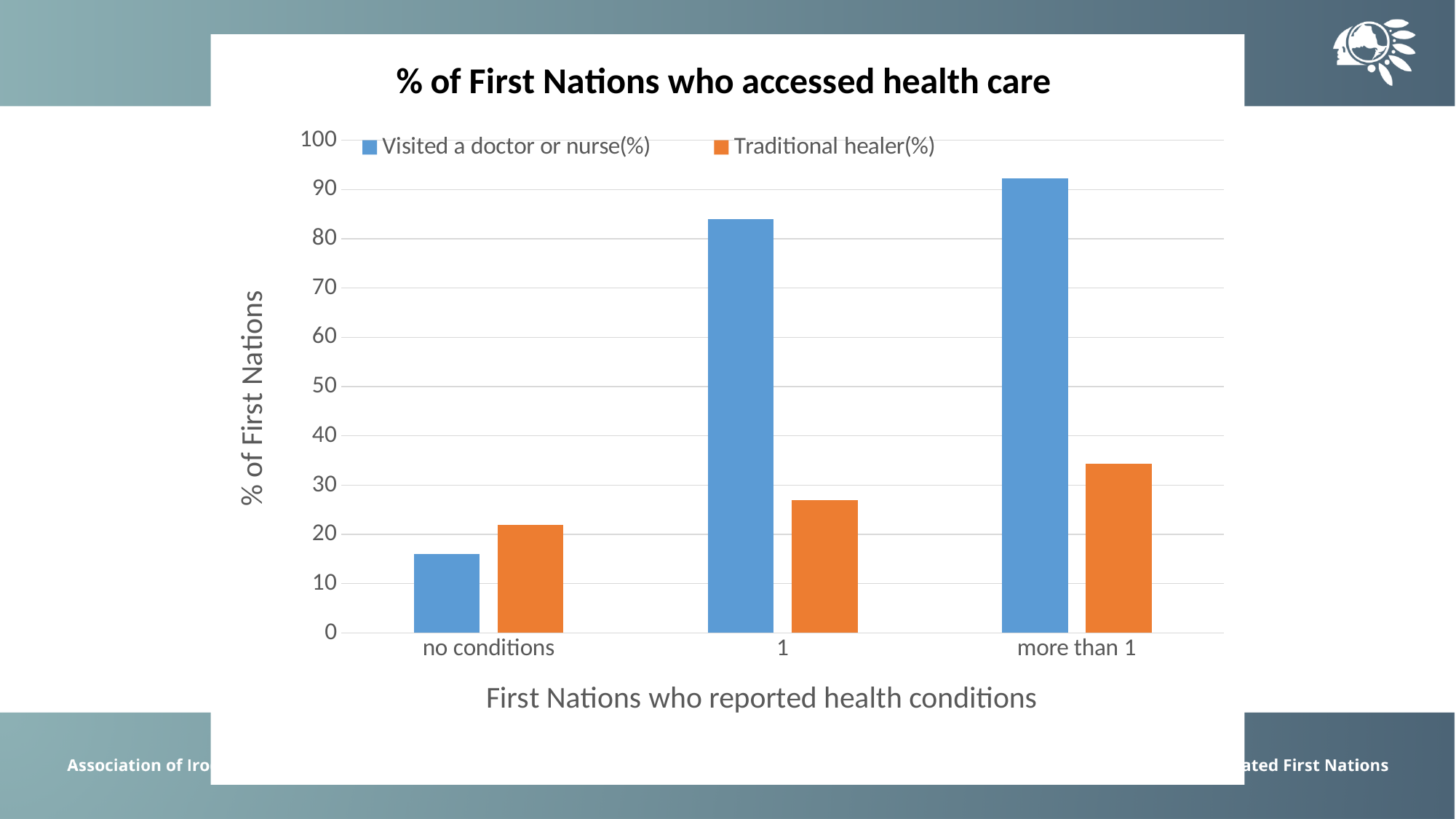
How many series does the legend list? 2 How many categories are shown on the x axis? 3 Which category has the highest value for Visited a doctor or nurse(%)? more than 1 What type of chart is shown on the slide? bar chart Is the value for Traditional healer(%) in the 'more than 1' category greater or less than 30? greater Is the value for Visited a doctor or nurse(%) in the 'no conditions' category greater or less than 20? less Is the value for Visited a doctor or nurse(%) in the '1' category greater or less than 80? greater In the 'no conditions' category, which series has the larger value: Visited a doctor or nurse(%) or Traditional healer(%)? Traditional healer(%) Which category has the lowest value for Traditional healer(%)? no conditions Do the values for Traditional healer(%) rise or fall from 'no conditions' to 'more than 1'? rise What is the title of the chart? % of First Nations who accessed health care